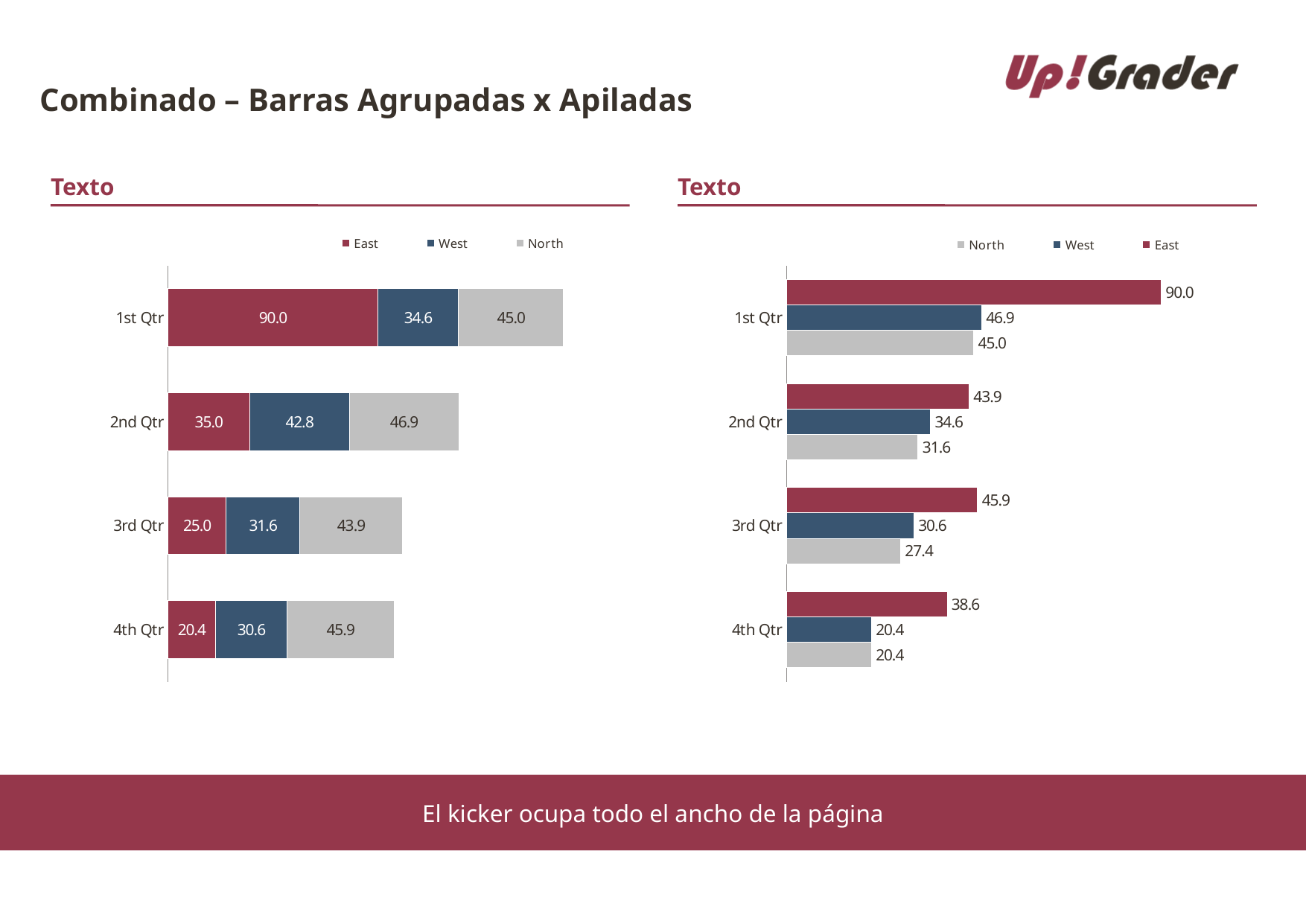
In the left chart, what is the total of the stacked bar for 3rd Qtr? 100.5 In the right chart, what is the North value for 3rd Qtr? 27.4 In the left chart, which quarter has the longest stacked bar? 1st Qtr How many series does the legend of the right chart list? 3 In the left chart, what is the East value for 1st Qtr? 90.0 In the left chart, what is the North value for 2nd Qtr? 46.9 In the right chart, what is the difference between the East and North values for 1st Qtr? 45.0 In the left chart, what is the difference between the West values for 2nd Qtr and 4th Qtr? 12.2 What kind of chart is the left chart? Stacked bar chart In the right chart, what is the West value for 1st Qtr? 46.9 In the right chart, which is larger for 2nd Qtr, the East value or the West value? East In the right chart, which quarter has the lowest East value? 4th Qtr